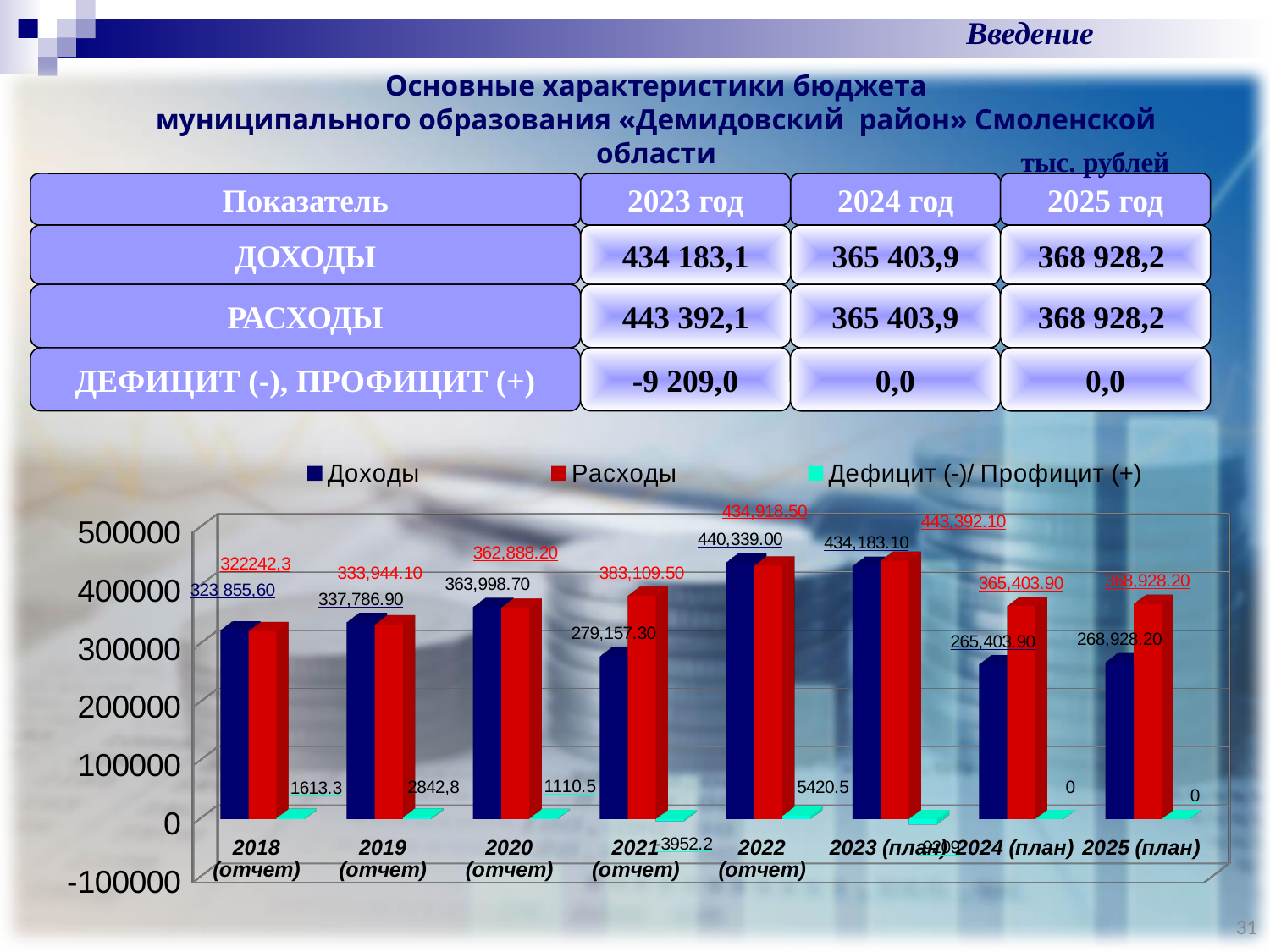
What kind of chart is shown on the slide? bar chart What is the value of Дефицит (-)/ Профицит (+) for 2022 (отчет) in the chart? 5420.5 What is the value of Расходы for 2023 (план) in the chart? 443,392.10 What is the difference between Расходы and Доходы for 2024 (план) in the chart? 100,000.00 Which year has the highest Доходы value in the chart? 2022 (отчет) Which year has the lowest Доходы value in the chart? 2024 (план) What is the value of Доходы for 2022 (отчет) in the chart? 440,339.00 Which year has the highest Расходы value in the chart? 2023 (план) For 2021 (отчет), which is larger in the chart: Доходы or Расходы? Расходы How many year categories are shown along the x axis of the chart? 8 Is the Доходы value for 2018 (отчет) greater or less than 400000? less How many series does the chart legend list? 3